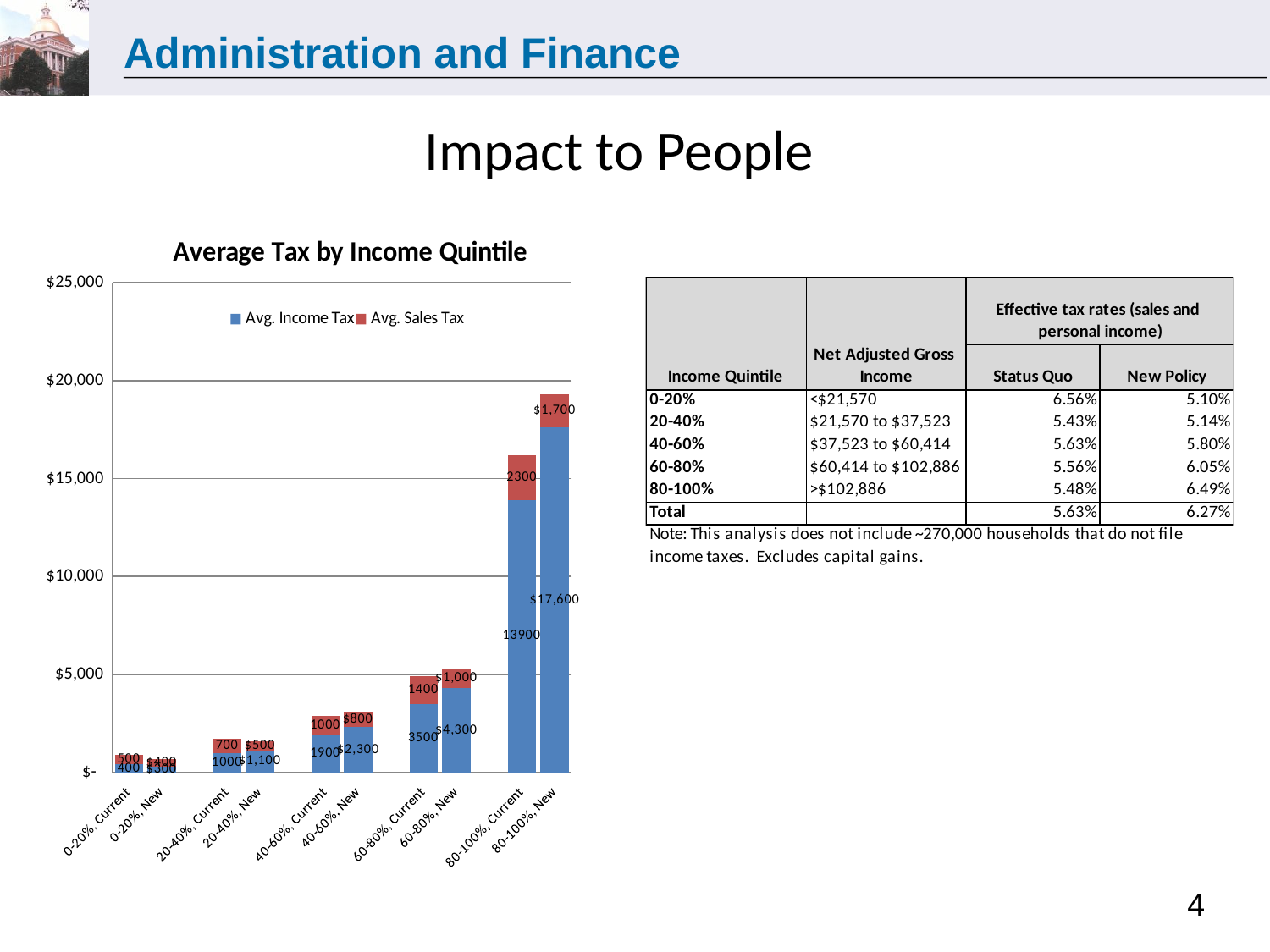
How much higher is the Avg. Income Tax for "80-100%, New" than for "80-100%, Current"? $3,700 How many bars are plotted in the "Average Tax by Income Quintile" chart? 10 What is the total of the stacked bar for "80-100%, Current"? $16,200 What is the Avg. Sales Tax value for "80-100%, Current"? 2300 Which is larger, the Avg. Sales Tax for "60-80%, Current" or for "60-80%, New"? 60-80%, Current Is the total of the "80-100%, Current" bar greater or less than $15,000? greater What is the total of the stacked bar for "80-100%, New"? $19,300 What is the Avg. Income Tax value for "60-80%, New"? $4,300 Which bar has the highest total in the "Average Tax by Income Quintile" chart? 80-100%, New How many series does the legend of the "Average Tax by Income Quintile" chart list? 2 What kind of chart is "Average Tax by Income Quintile"? Stacked bar chart What is the Avg. Income Tax value for "80-100%, New"? $17,600